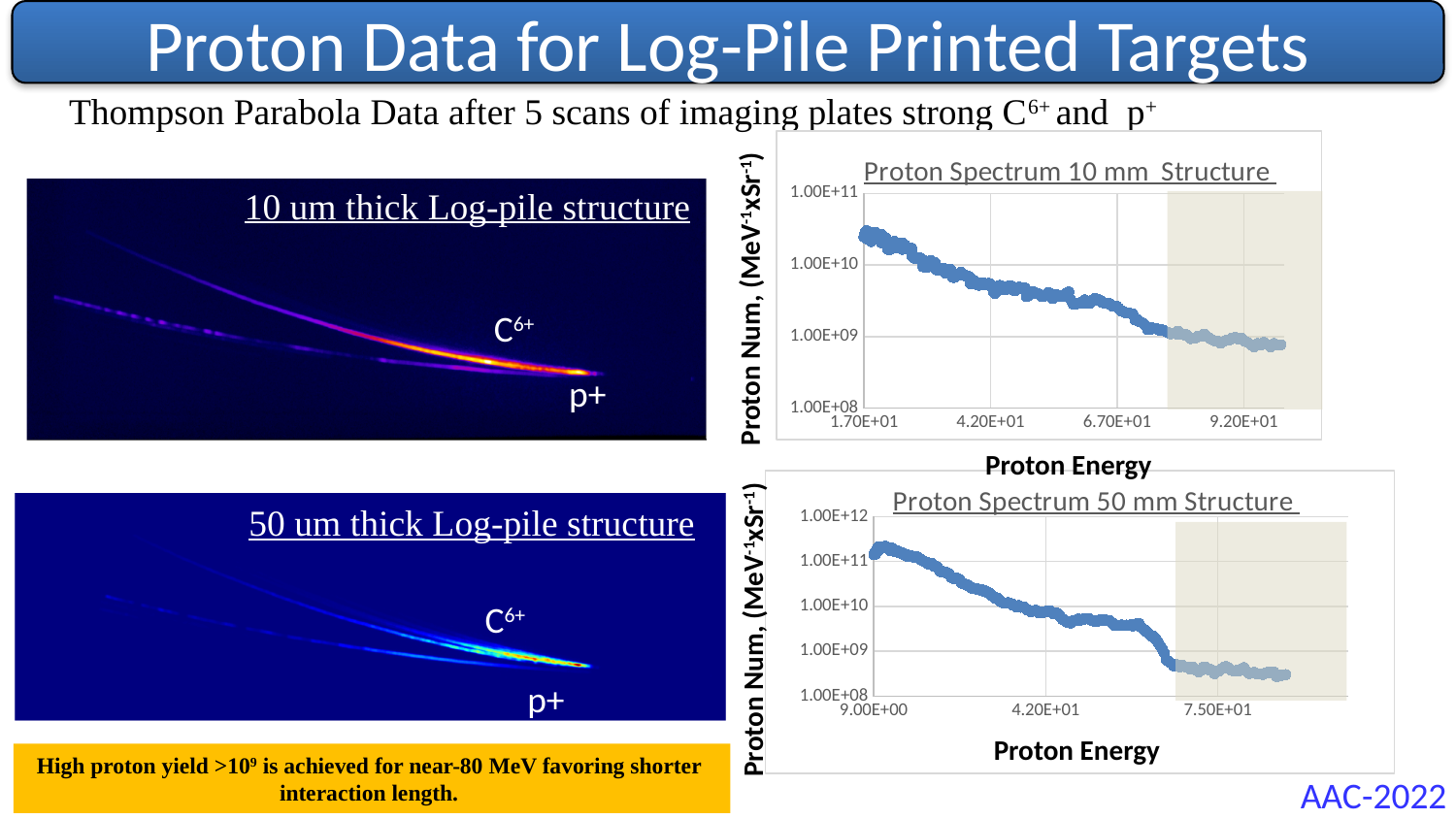
How many charts are shown on the slide? 2 In the 'Proton Spectrum 10 mm Structure' chart, do the values rise or fall as proton energy increases? fall What is the highest y-axis tick shown on the 'Proton Spectrum 50 mm Structure' chart? 1.00E+12 What is the x-axis label of the 'Proton Spectrum 10 mm Structure' chart? Proton Energy In the 'Proton Spectrum 50 mm Structure' chart, is the proton number at 9.00E+00 greater or less than 1.00E+11? greater In the 'Proton Spectrum 50 mm Structure' chart, which has the larger proton number: the point at 4.20E+01 or the point at 7.50E+01? 4.20E+01 In the 'Proton Spectrum 10 mm Structure' chart, is the proton number at 1.70E+01 greater or less than 1.00E+10? greater In the 'Proton Spectrum 50 mm Structure' chart, is the proton number at 7.50E+01 greater or less than 1.00E+09? less In the 'Proton Spectrum 10 mm Structure' chart, which has the larger proton number: the point at 1.70E+01 or the point at 9.20E+01? 1.70E+01 In the 'Proton Spectrum 50 mm Structure' chart, do the values rise or fall along the x axis? fall What kind of chart is the 'Proton Spectrum 10 mm Structure' chart? scatter chart